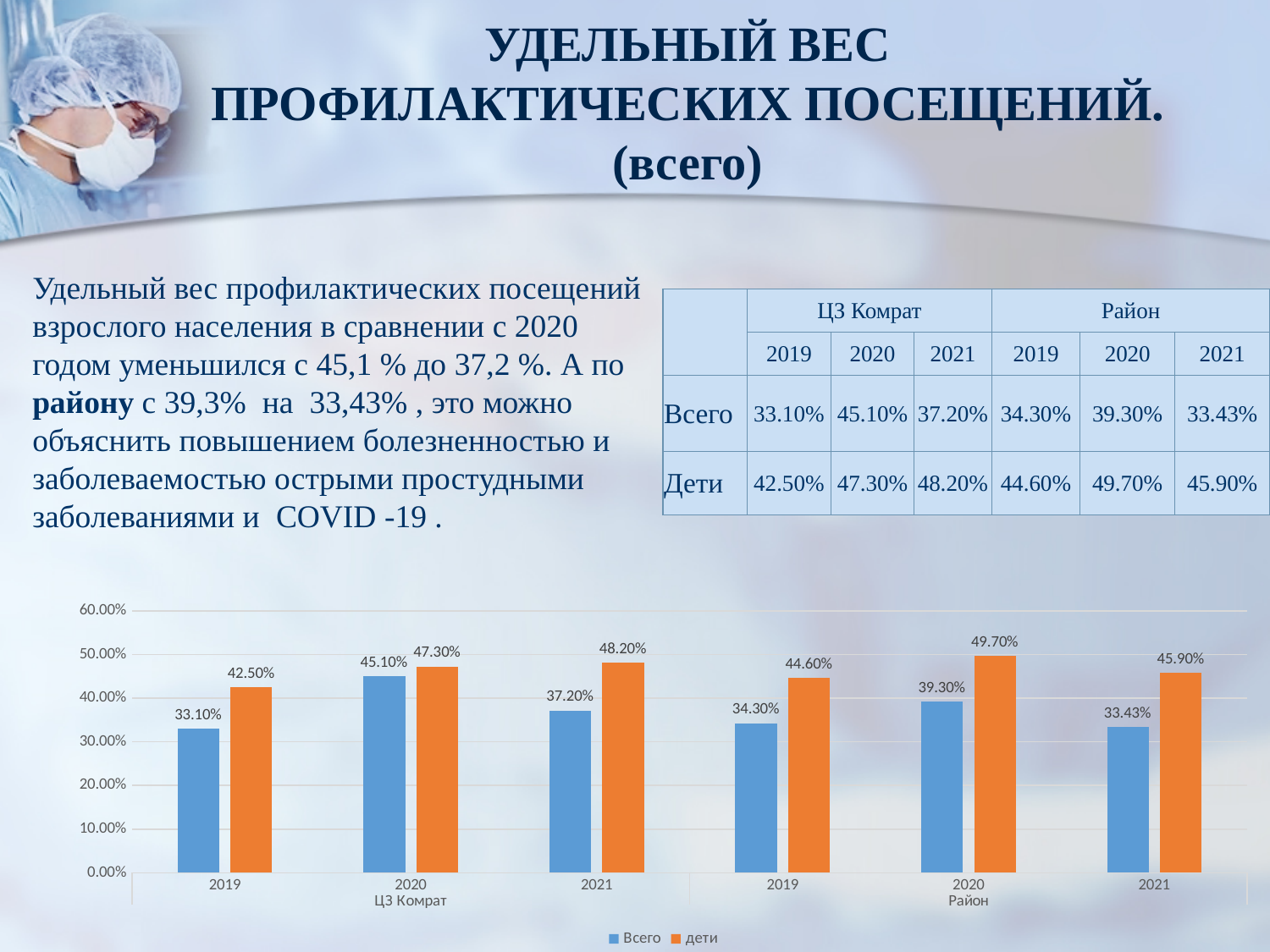
Which category has the highest value for the дети series? Район 2020 How many series does the chart legend list? 2 What colour are the bars for the дети series? orange Does the Всего series rise or fall from 2020 to 2021 for Район? fall Which is larger: Всего for ЦЗ Комрат in 2020 or Всего for Район in 2020? ЦЗ Комрат 2020 What is the value of Всего for ЦЗ Комрат in 2020? 45.10% What is the value of дети for Район in 2021? 45.90% What type of chart is shown on the slide? bar chart How many year categories are shown on the x axis of the chart? 6 What is the value of Всего for Район in 2019? 34.30% Which category has the lowest value for the Всего series? ЦЗ Комрат 2019 What is the difference between the дети and Всего values for ЦЗ Комрат in 2021? 11.00%